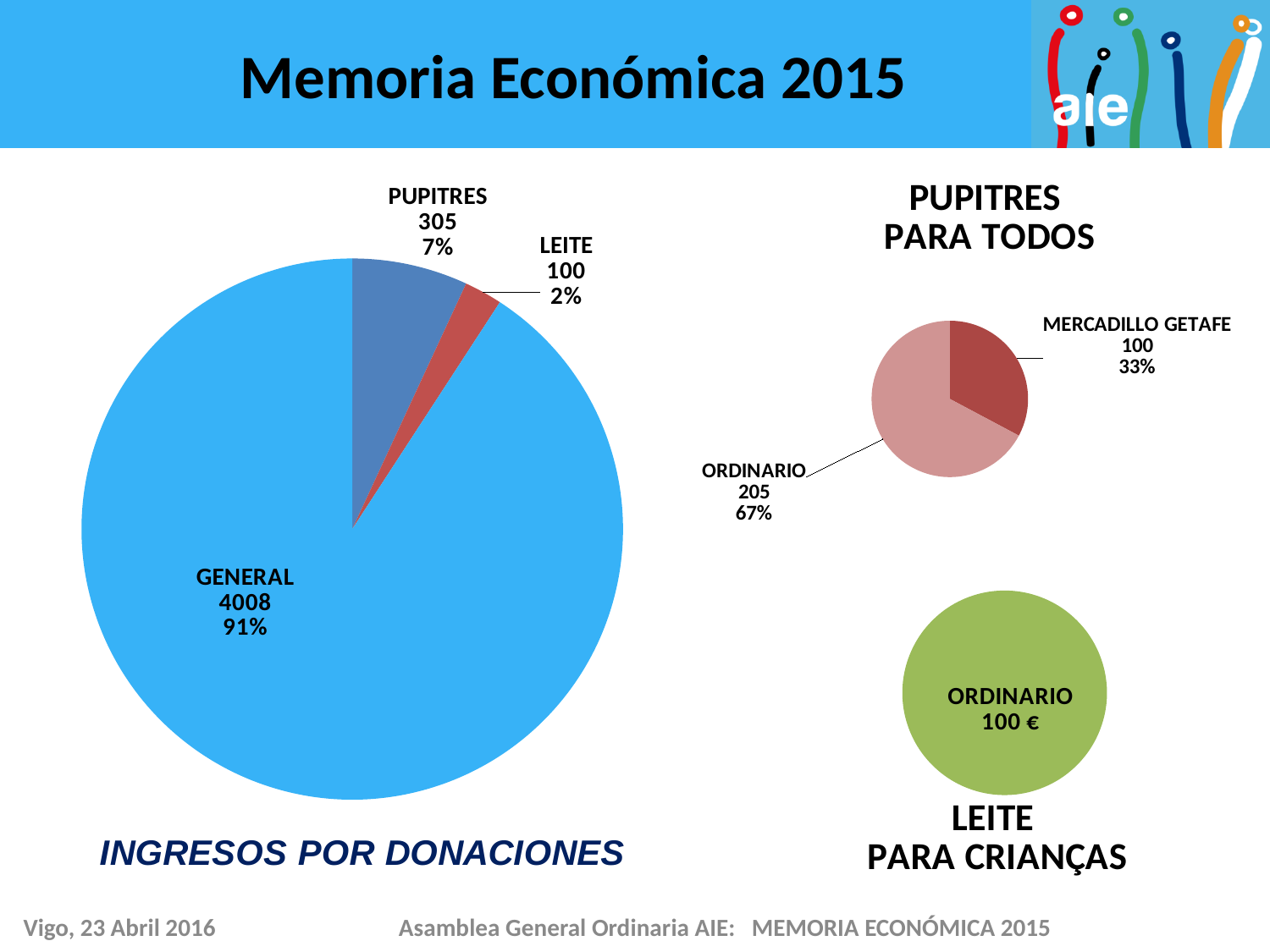
How many slices does the INGRESOS POR DONACIONES chart have? 3 In the INGRESOS POR DONACIONES chart, what is the difference between the GENERAL and PUPITRES values? 3703 In the INGRESOS POR DONACIONES chart, what is the value for GENERAL? 4008 In the INGRESOS POR DONACIONES chart, what percentage share does PUPITRES have? 7% In the LEITE PARA CRIANÇAS chart, what is the value for ORDINARIO? 100 € In the PUPITRES PARA TODOS chart, which is larger, ORDINARIO or MERCADILLO GETAFE? ORDINARIO What kind of chart is the INGRESOS POR DONACIONES chart? Pie chart In the INGRESOS POR DONACIONES chart, which category is the smallest? LEITE In the INGRESOS POR DONACIONES chart, what is the value for LEITE? 100 In the INGRESOS POR DONACIONES chart, which category is the largest? GENERAL In the PUPITRES PARA TODOS chart, what is the value for ORDINARIO? 205 In the PUPITRES PARA TODOS chart, what percentage share does MERCADILLO GETAFE have? 33%